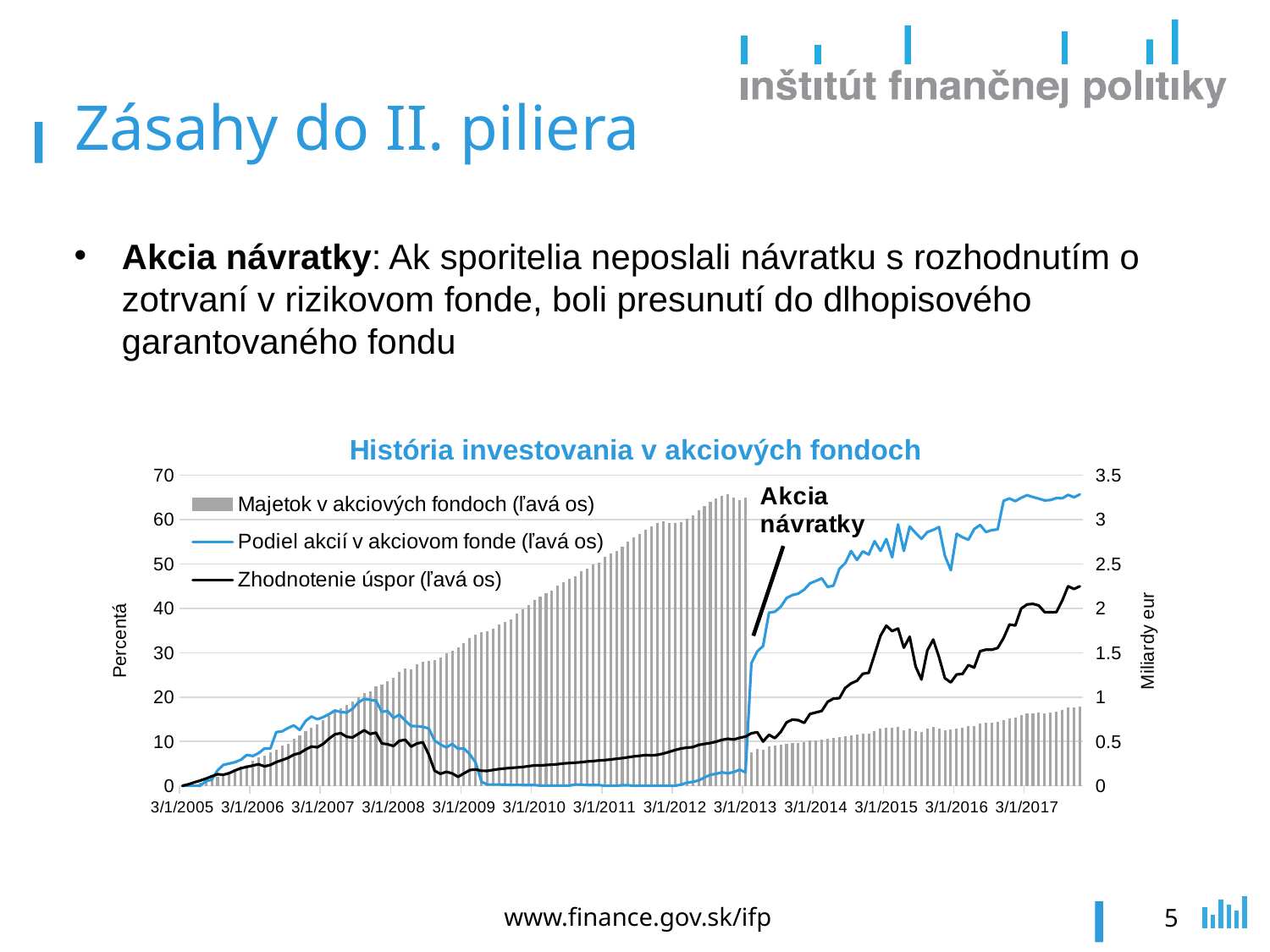
What is the title of the chart on the slide? História investovania v akciových fondoch Is the value of Podiel akcií v akciovom fonde at 3/1/2017 greater or less than 60? greater Which series in the chart is drawn as bars rather than a line? Majetok v akciových fondoch (ľavá os) What is the highest value shown on the left vertical axis of the chart? 70 What is the label of the right-hand vertical axis of the chart? Miliardy eur How many series does the chart legend list? 3 What is the highest value shown on the right vertical axis of the chart? 3.5 Does the Podiel akcií v akciovom fonde line rise or fall between 3/1/2013 and 3/1/2017? rise How many date labels are shown along the x axis of the chart? 13 Is the value of Podiel akcií v akciovom fonde at 3/1/2011 greater or less than 10? less Do the Majetok v akciových fondoch bars rise or fall between 3/1/2009 and 3/1/2013? rise What is the label of the left-hand vertical axis of the chart? Percentá